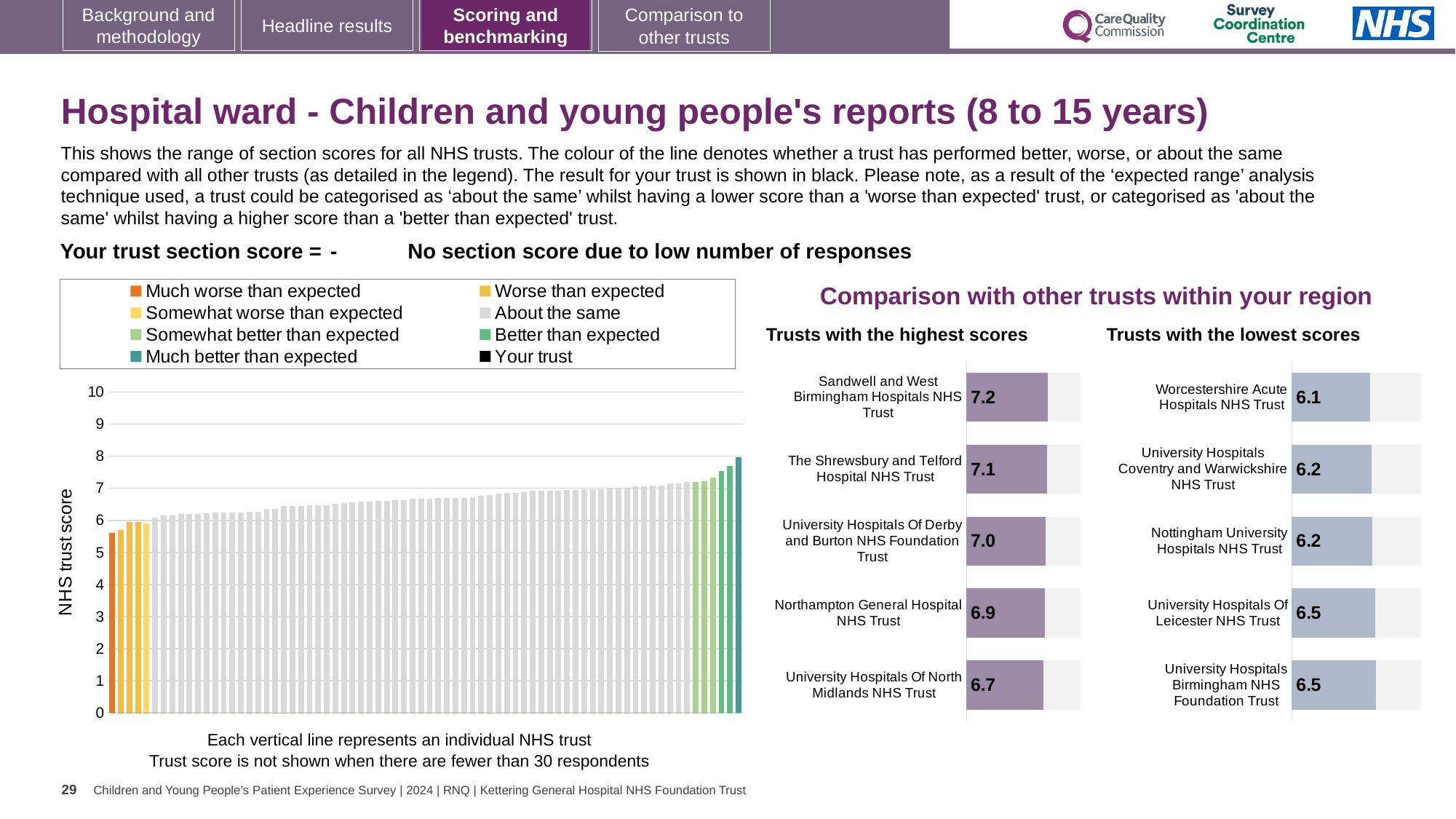
In the 'NHS trust score' chart on the left, is the value of the tallest bar greater or less than 7? greater Comparing the two right-hand charts, which has the higher score: Northampton General Hospital NHS Trust or University Hospitals Of Leicester NHS Trust? Northampton General Hospital NHS Trust In the 'Trusts with the highest scores' chart, what is the difference between the scores of Sandwell and West Birmingham Hospitals NHS Trust and University Hospitals Of North Midlands NHS Trust? 0.5 In the 'NHS trust score' chart on the left, do the bar values rise or fall from left to right? rise How many trusts are shown in the 'Trusts with the highest scores' chart? 5 In the 'Trusts with the lowest scores' chart, what is the score for Worcestershire Acute Hospitals NHS Trust? 6.1 In the 'Trusts with the highest scores' chart, which trust has the highest score? Sandwell and West Birmingham Hospitals NHS Trust In the 'Trusts with the highest scores' chart, what is the score for Sandwell and West Birmingham Hospitals NHS Trust? 7.2 What kind of chart is the 'NHS trust score' chart on the left? bar chart What is the y-axis title of the bar chart on the left of the slide? NHS trust score In the 'Trusts with the lowest scores' chart, which trust has the lowest score? Worcestershire Acute Hospitals NHS Trust How many entries does the legend of the 'NHS trust score' chart on the left list? 8